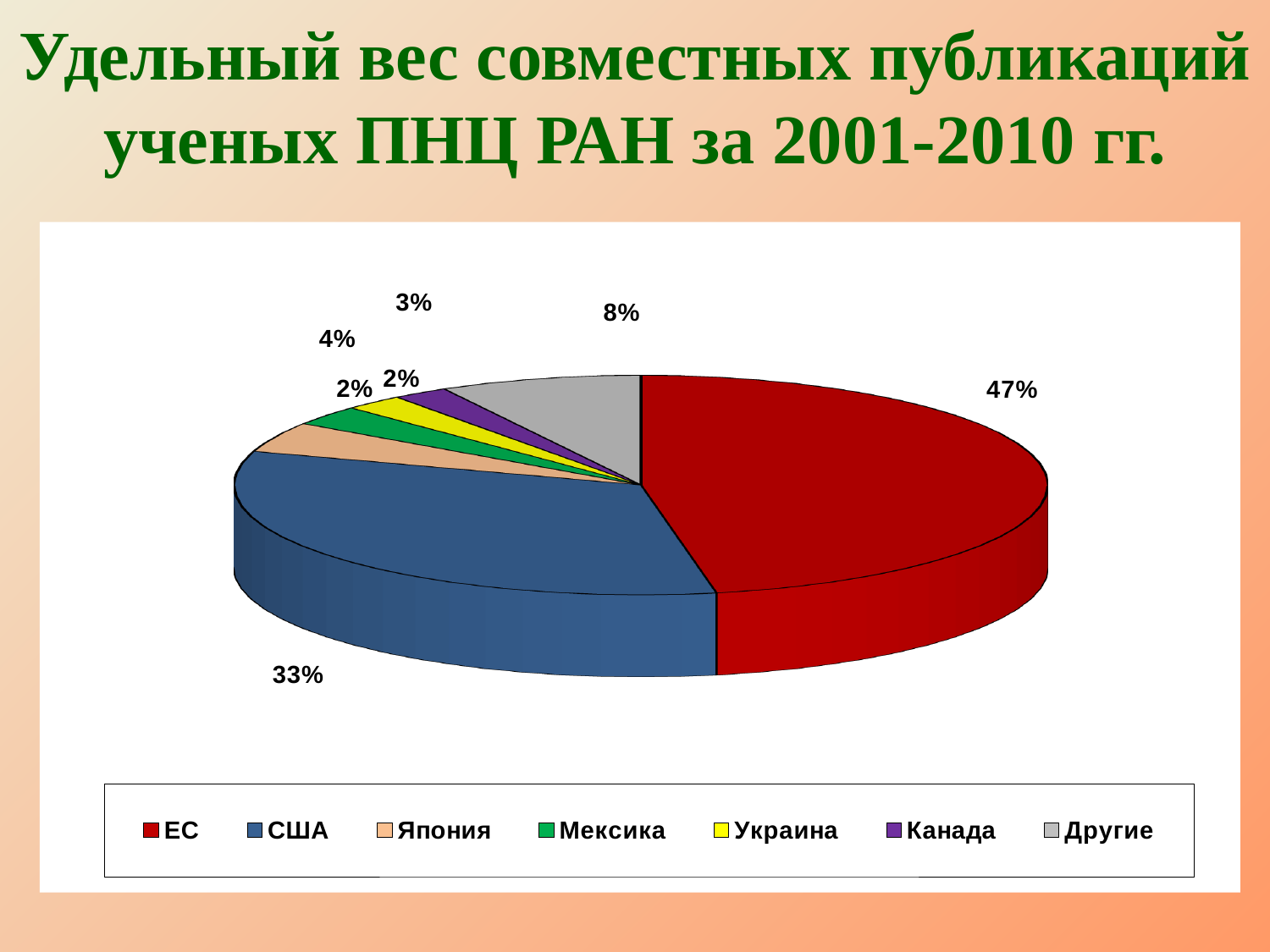
Which category is shown in grey? Другие What share of the pie does ЕС have? 47% Which category has the largest share of the pie? ЕС What is the difference between the shares of ЕС and США? 14% What share of the pie does Япония have? 4% Which has a larger share, Другие or Япония? Другие What share of the pie does Канада have? 2% What kind of chart is shown on the slide? pie chart How many categories does the legend list? 7 What share of the pie does Другие have? 8% What colour is the slice for США? blue What share of the pie does США have? 33%